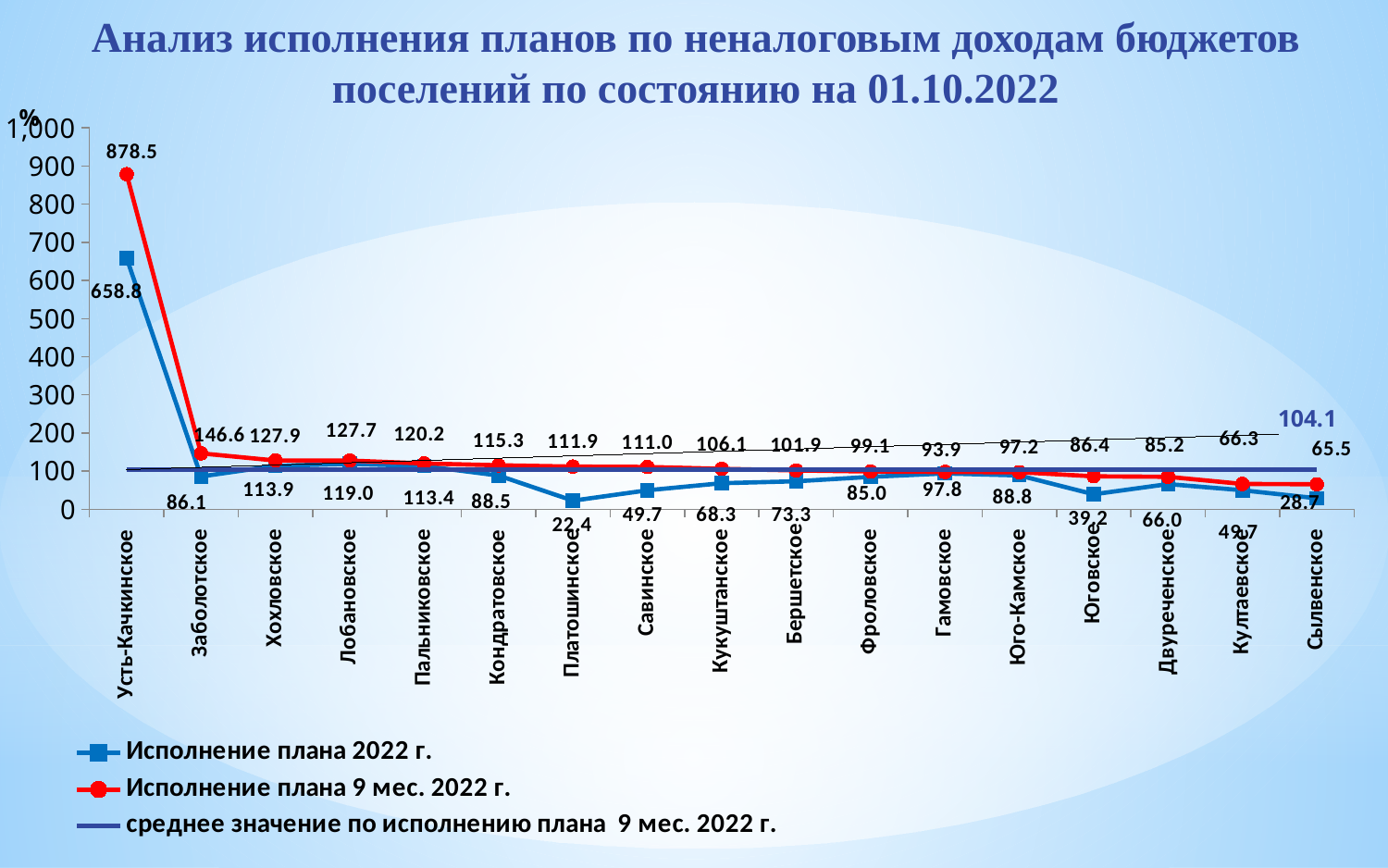
Which series is drawn with red circle markers according to the legend? Исполнение плана 9 мес. 2022 г. What is the value of the line 'среднее значение по исполнению плана 9 мес. 2022 г.'? 104.1 What is the value of 'Исполнение плана 9 мес. 2022 г.' for Усть-Качкинское? 878.5 What is the value of 'Исполнение плана 9 мес. 2022 г.' for Сылвенское? 65.5 What is the difference between 'Исполнение плана 9 мес. 2022 г.' and 'Исполнение плана 2022 г.' for Усть-Качкинское? 219.7 What type of chart is shown on the slide? line chart For Заболотское, which is larger: 'Исполнение плана 2022 г.' or 'Исполнение плана 9 мес. 2022 г.'? Исполнение плана 9 мес. 2022 г. Which settlement has the highest value for 'Исполнение плана 9 мес. 2022 г.'? Усть-Качкинское How many settlements (categories) are plotted along the x axis? 17 What is the value of 'Исполнение плана 2022 г.' for Платошинское? 22.4 How many series does the legend list? 3 Which settlement has the lowest value for 'Исполнение плана 2022 г.'? Платошинское